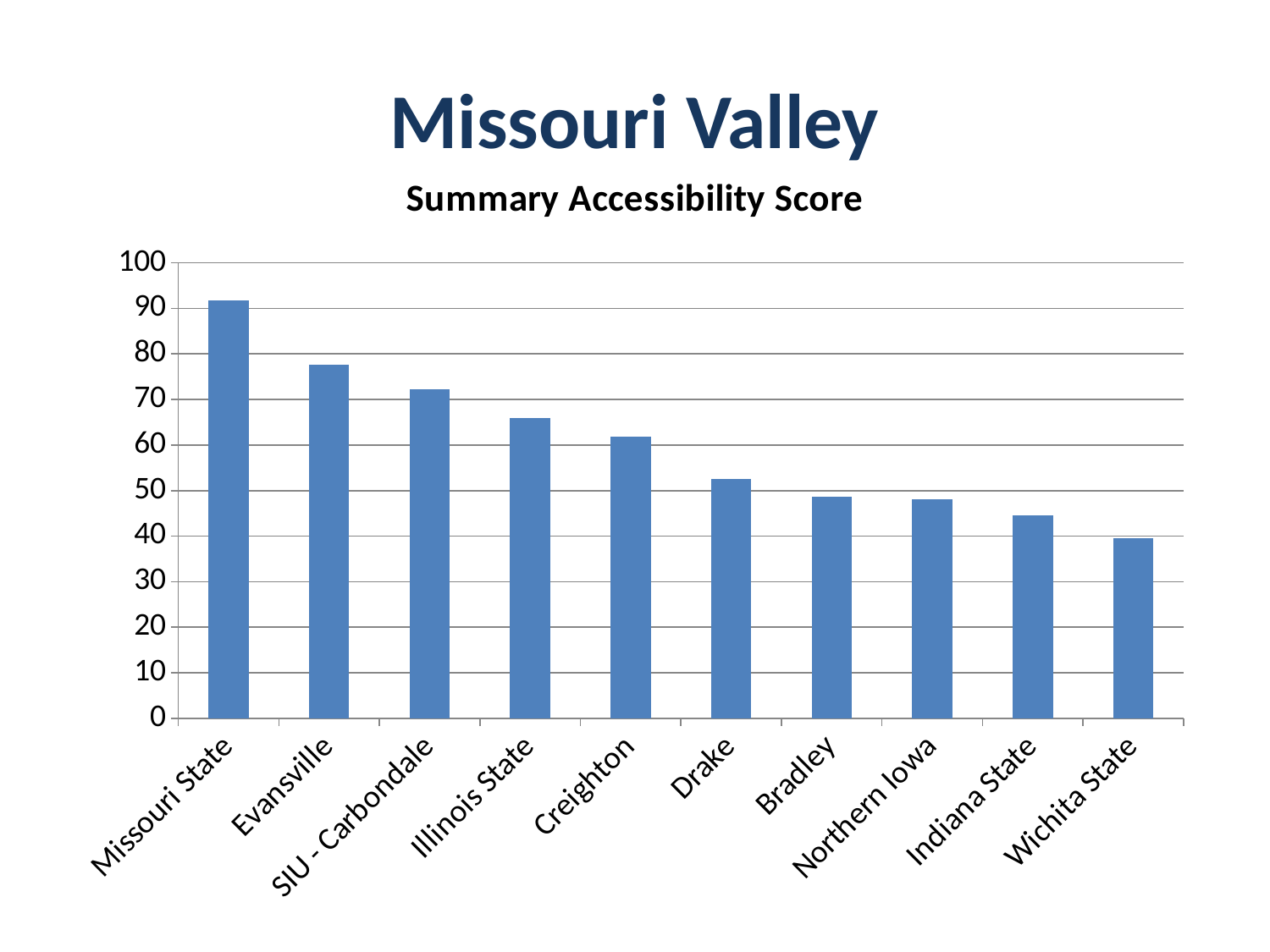
Is the value for Evansville greater or less than 80? less What is the title of the chart? Summary Accessibility Score Is the value for Drake greater or less than 50? greater Which school has the lowest Summary Accessibility Score? Wichita State Which has a higher score, Illinois State or Creighton? Illinois State Do the values rise or fall moving from left to right along the x axis? fall What kind of chart is shown on the slide? bar chart Is the value for SIU - Carbondale greater or less than 70? greater How many schools are shown on the chart? 10 Which school has the highest Summary Accessibility Score? Missouri State